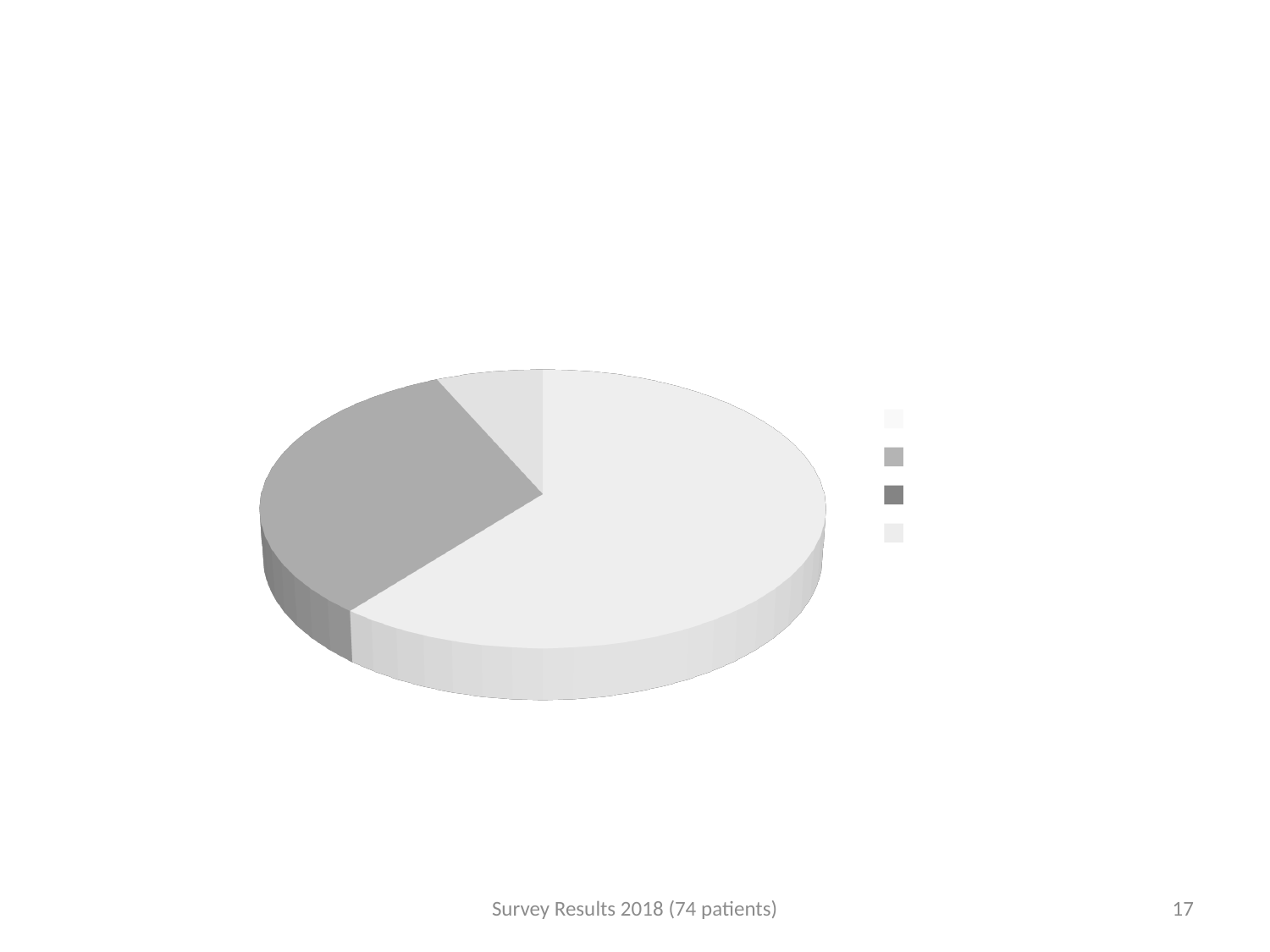
What kind of chart is shown on the slide? pie chart Is the largest slice of the pie chart more or less than half of the pie? more Does the pie chart display a title? No How many entries does the legend of the pie chart list? 4 Is the pie chart drawn in 3D? Yes